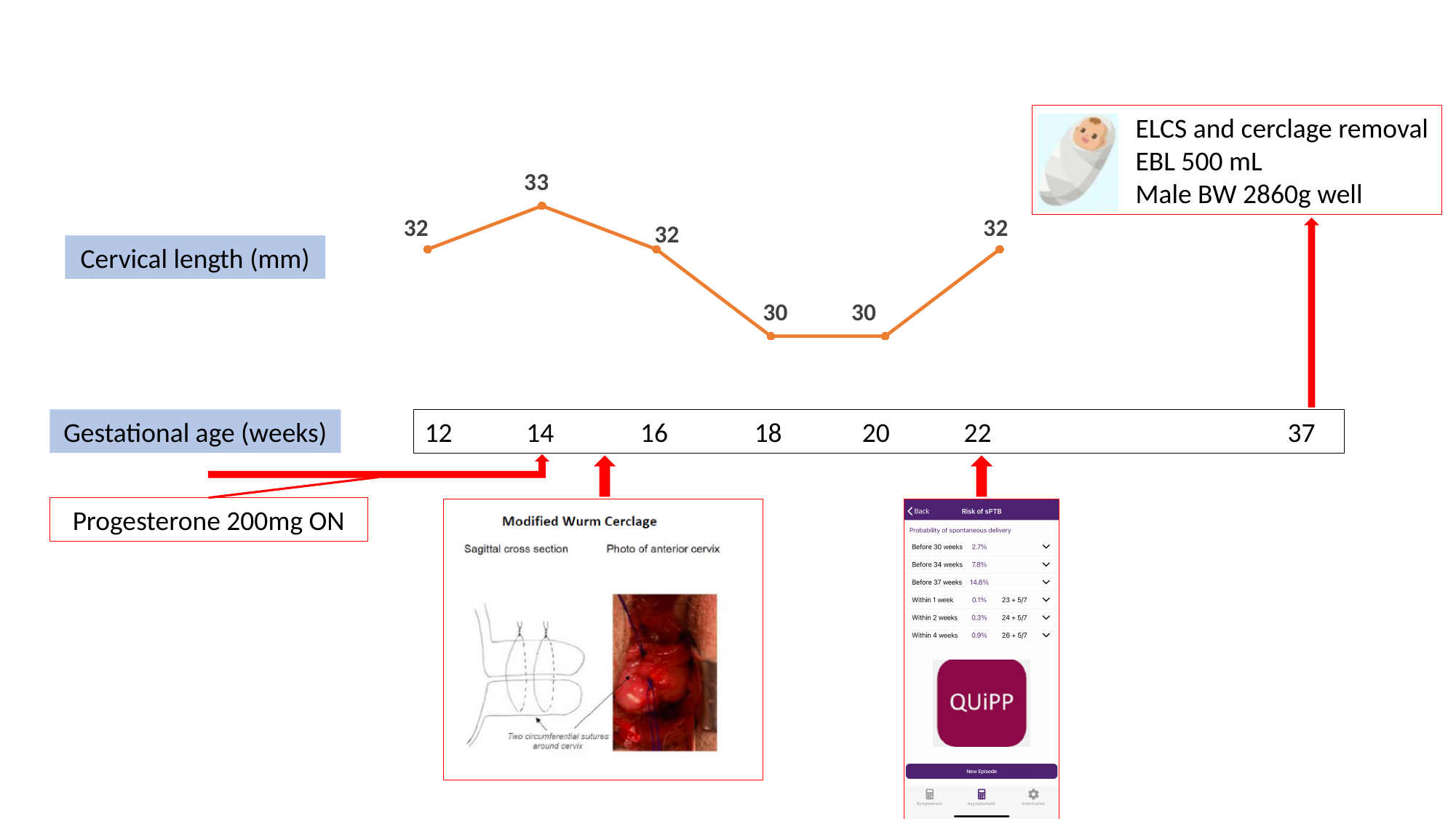
Does the cervical length rise or fall between 16 weeks and 18 weeks? fall What is the lowest cervical length plotted on the chart? 30 At which gestational age is the cervical length highest? 14 weeks What kind of chart is used to show cervical length? line chart What is the difference between the cervical length at 14 weeks and at 18 weeks? 3 How many cervical length data points are plotted on the chart? 6 What is the label of the measurement plotted on the chart? Cervical length (mm) What is the cervical length at 14 weeks gestational age? 33 What is the cervical length at 22 weeks gestational age? 32 What is the cervical length at 18 weeks gestational age? 30 Which is larger, the cervical length at 12 weeks or at 20 weeks? 12 weeks What colour is the cervical length line on the chart? orange